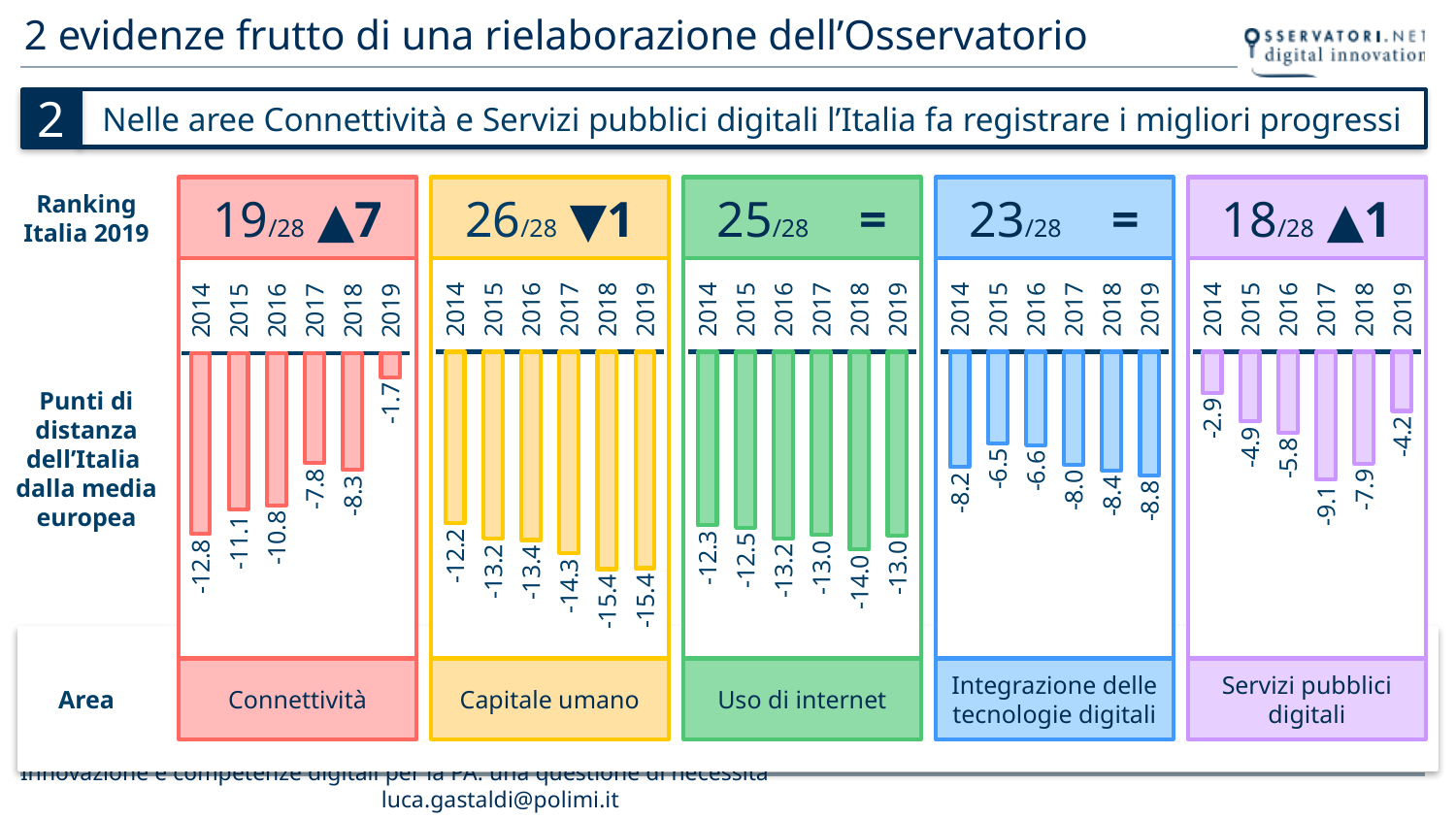
What kind of chart is used to show the distance of Italy from the European average? Bar chart In the Connettività chart, what is the value for 2019? -1.7 In the Servizi pubblici digitali chart, what is the difference between the 2017 value (-9.1) and the 2018 value (-7.9)? 1.2 In the Connettività chart, what is the difference between the 2014 value (-12.8) and the 2019 value (-1.7)? 11.1 How many years are plotted in each chart? 6 In the Connettività chart, which year has the value closest to zero? 2019 In the Capitale umano chart, what is the value for 2017? -14.3 In the Uso di internet chart, which year has the larger gap from the European average, 2014 or 2018? 2018 In the Integrazione delle tecnologie digitali chart, what is the value for 2015? -6.5 In the Capitale umano chart, do the values become more negative or less negative from 2014 to 2019? More negative In the Uso di internet chart, what is the value for 2018? -14.0 In the Servizi pubblici digitali chart, which year has the largest distance from the European average (most negative value)? 2017